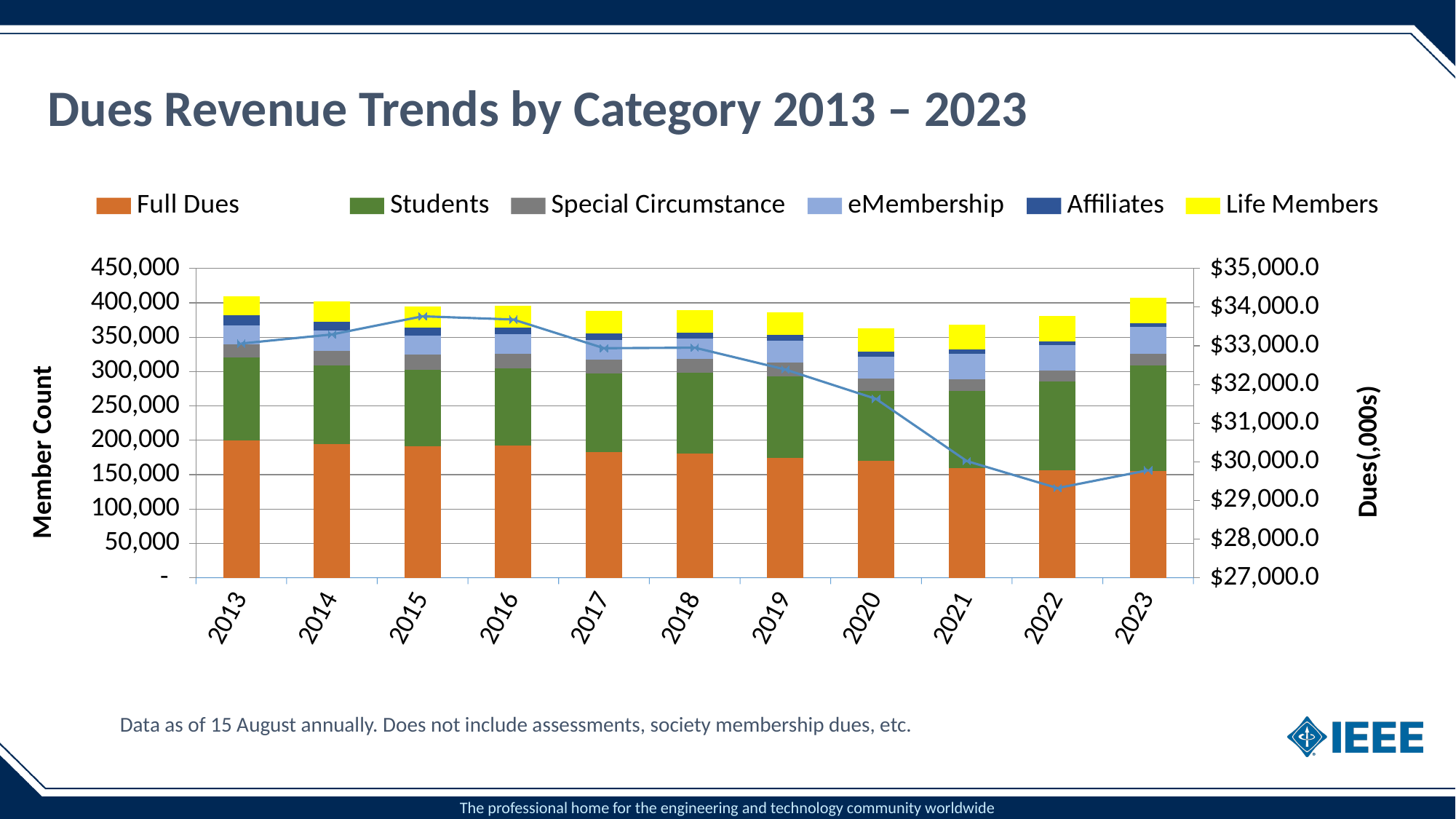
Which year has the lowest value on the dues line? 2022 Which is larger, the Full Dues member count in 2013 or in 2023? 2013 Is the Full Dues member count for 2020 greater or less than 150,000? greater What is the label of the left vertical axis? Member Count How many years are shown along the x axis of the chart? 11 Is the dues line value for 2015 greater or less than $33,000.0? greater Is the dues line value for 2022 greater or less than $30,000.0? less What is the title of the chart on the slide? Dues Revenue Trends by Category 2013 – 2023 How many series does the chart legend list? 6 What kind of chart is shown on the slide? Stacked bar chart with a line